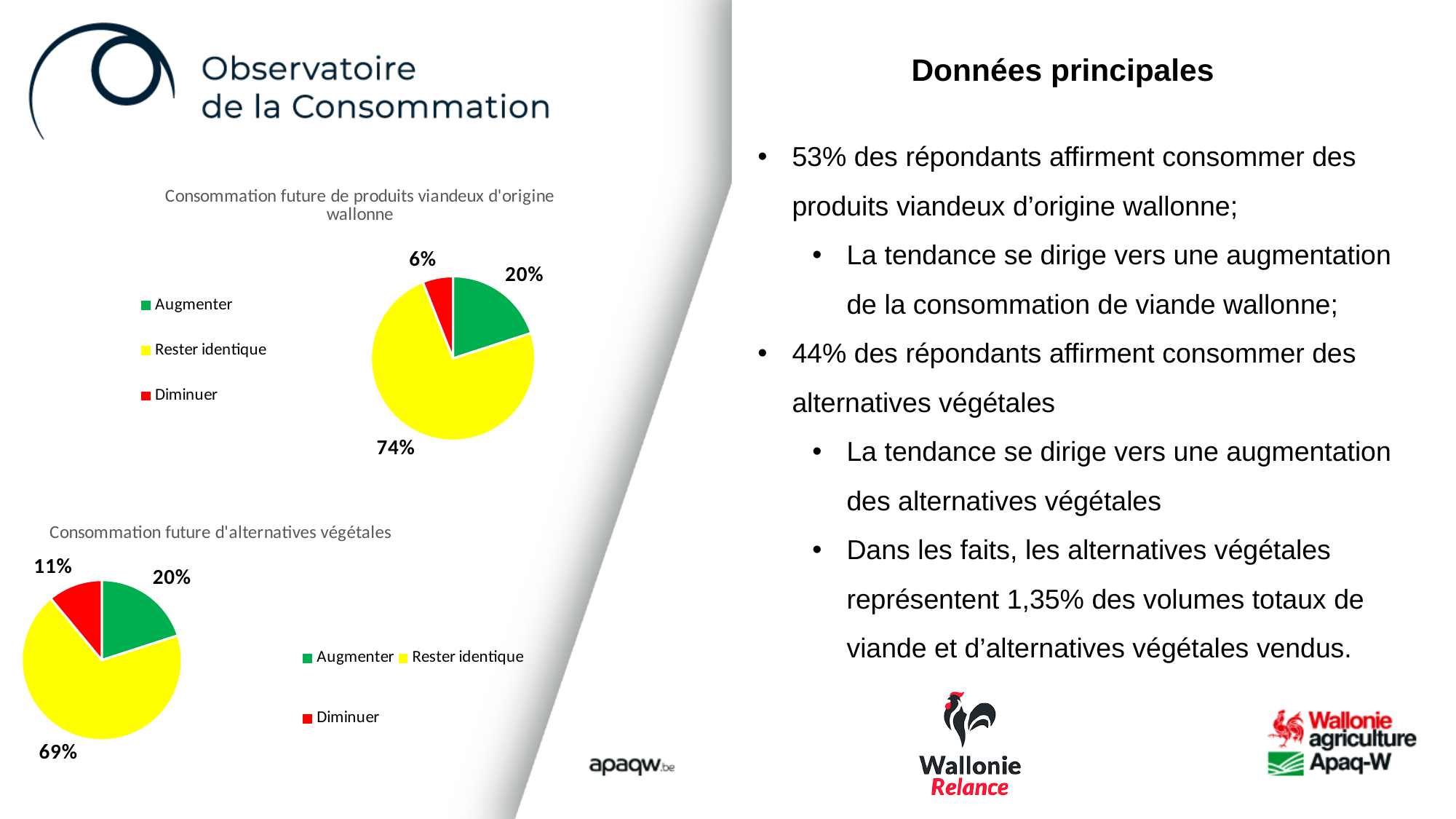
In the chart 'Consommation future d'alternatives végétales', what share is 'Diminuer'? 11% In the chart 'Consommation future d'alternatives végétales', which category has the smallest share? Diminuer In the chart 'Consommation future d'alternatives végétales', what colour is the 'Rester identique' slice? Yellow In the chart 'Consommation future de produits viandeux d'origine wallonne', which category has the largest share? Rester identique In the chart 'Consommation future de produits viandeux d'origine wallonne', what is the difference between 'Augmenter' and 'Diminuer'? 14% In the chart 'Consommation future d'alternatives végétales', what share is 'Rester identique'? 69% In the chart 'Consommation future d'alternatives végétales', which is larger, 'Augmenter' or 'Diminuer'? Augmenter How many categories does the chart 'Consommation future de produits viandeux d'origine wallonne' show? 3 In the chart 'Consommation future de produits viandeux d'origine wallonne', what share is 'Augmenter'? 20% What type of chart is 'Consommation future d'alternatives végétales'? Pie chart In the chart 'Consommation future de produits viandeux d'origine wallonne', what share is 'Diminuer'? 6% In the chart 'Consommation future de produits viandeux d'origine wallonne', what share is 'Rester identique'? 74%